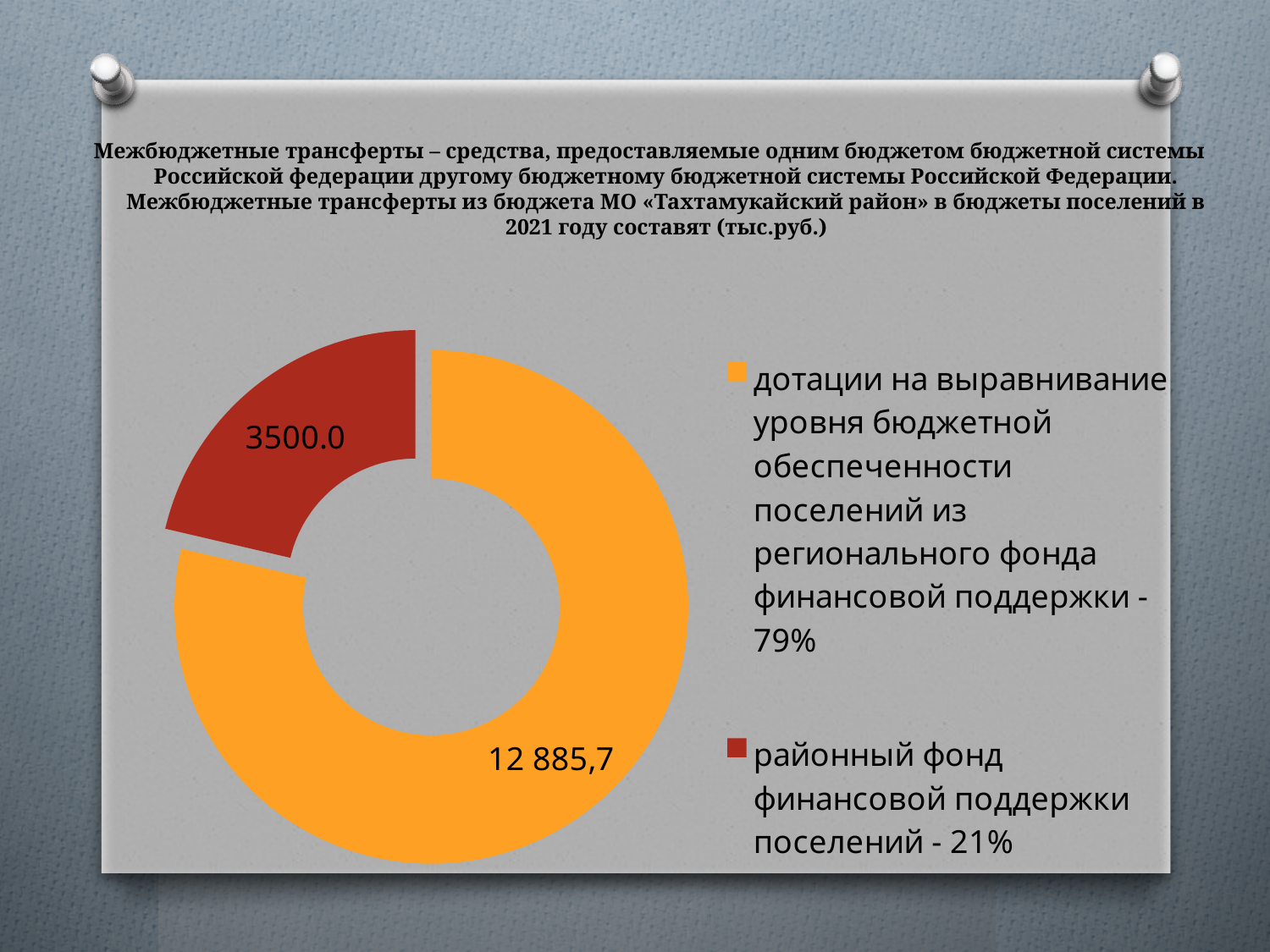
How many categories does the chart show? 2 What colour is the segment for «районный фонд финансовой поддержки поселений»? red What is the value for «дотации на выравнивание уровня бюджетной обеспеченности поселений из регионального фонда финансовой поддержки»? 12 885,7 Which is larger: the value for «районный фонд финансовой поддержки поселений» or the value for «дотации на выравнивание уровня бюджетной обеспеченности поселений»? дотации на выравнивание уровня бюджетной обеспеченности поселений What share of the chart does «районный фонд финансовой поддержки поселений» represent? 21% What share of the chart do the «дотации на выравнивание уровня бюджетной обеспеченности поселений» represent? 79% Which category has the largest segment of the chart? дотации на выравнивание уровня бюджетной обеспеченности поселений из регионального фонда финансовой поддержки In what units are the values on the chart given, according to the slide title? тыс.руб. What kind of chart is shown on the slide? doughnut (pie) chart What is the value for «районный фонд финансовой поддержки поселений»? 3500.0 What colour is the segment for «дотации на выравнивание уровня бюджетной обеспеченности поселений»? orange Which category has the smallest segment of the chart? районный фонд финансовой поддержки поселений